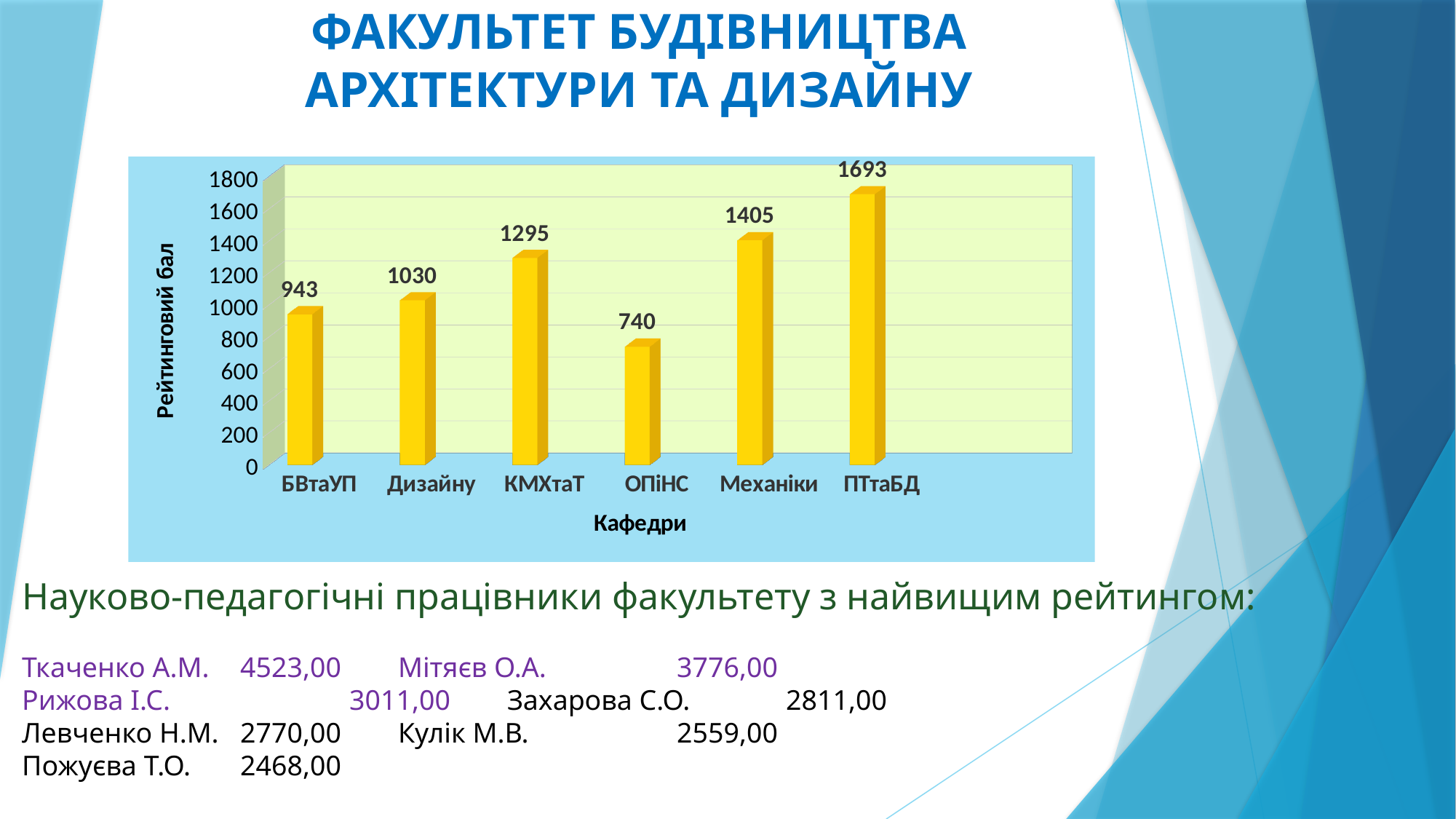
How many departments are shown in the chart? 6 What is the rating score for the Дизайну department? 1030 Is the value for БВтаУП greater or less than 1000? less What is the difference between the rating scores of ПТтаБД and Механіки? 288 Which has a higher rating score, Механіки or КМХтаТ? Механіки What is the rating score for the КМХтаТ department? 1295 Which department has the lowest rating score? ОПіНС What kind of chart is shown on the slide? bar chart Which department has the highest rating score? ПТтаБД What is the difference between the rating scores of Дизайну and БВтаУП? 87 What is the label of the vertical axis of the chart? Рейтинговий бал What is the rating score for the ОПіНС department? 740